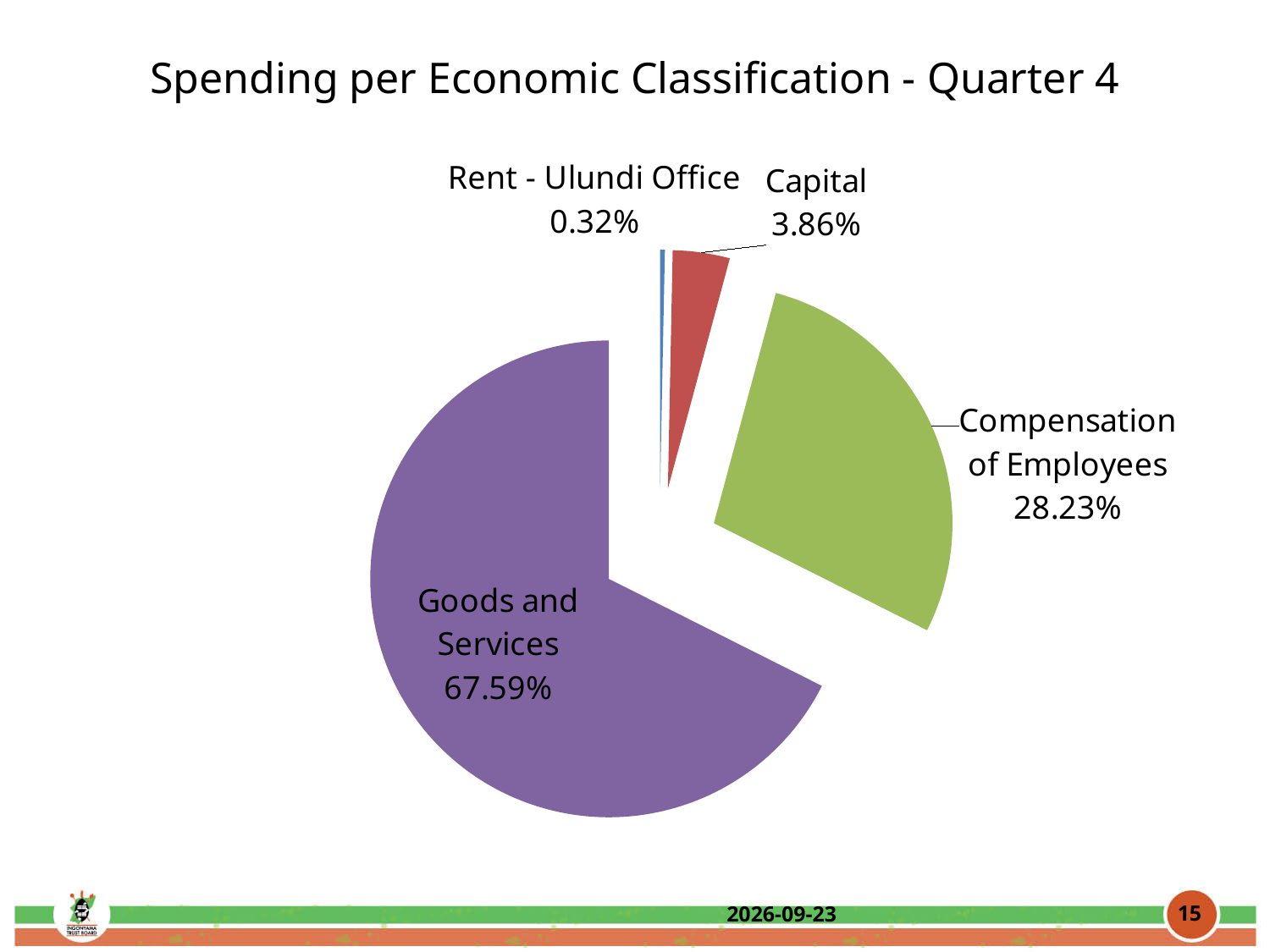
Which category has the smallest share of spending? Rent - Ulundi Office What is the difference in percentage points between Goods and Services and Compensation of Employees? 39.36 Which category has the largest share of spending? Goods and Services What colour is the Goods and Services slice? Purple Which is larger, the share for Capital or the share for Rent - Ulundi Office? Capital How many categories are shown in the pie chart? 4 What share of spending is Compensation of Employees? 28.23% What share of spending is Capital? 3.86% What share of spending is Rent - Ulundi Office? 0.32% What share of spending is Goods and Services? 67.59% What is the title of the chart? Spending per Economic Classification - Quarter 4 What type of chart is shown on the slide? Pie chart